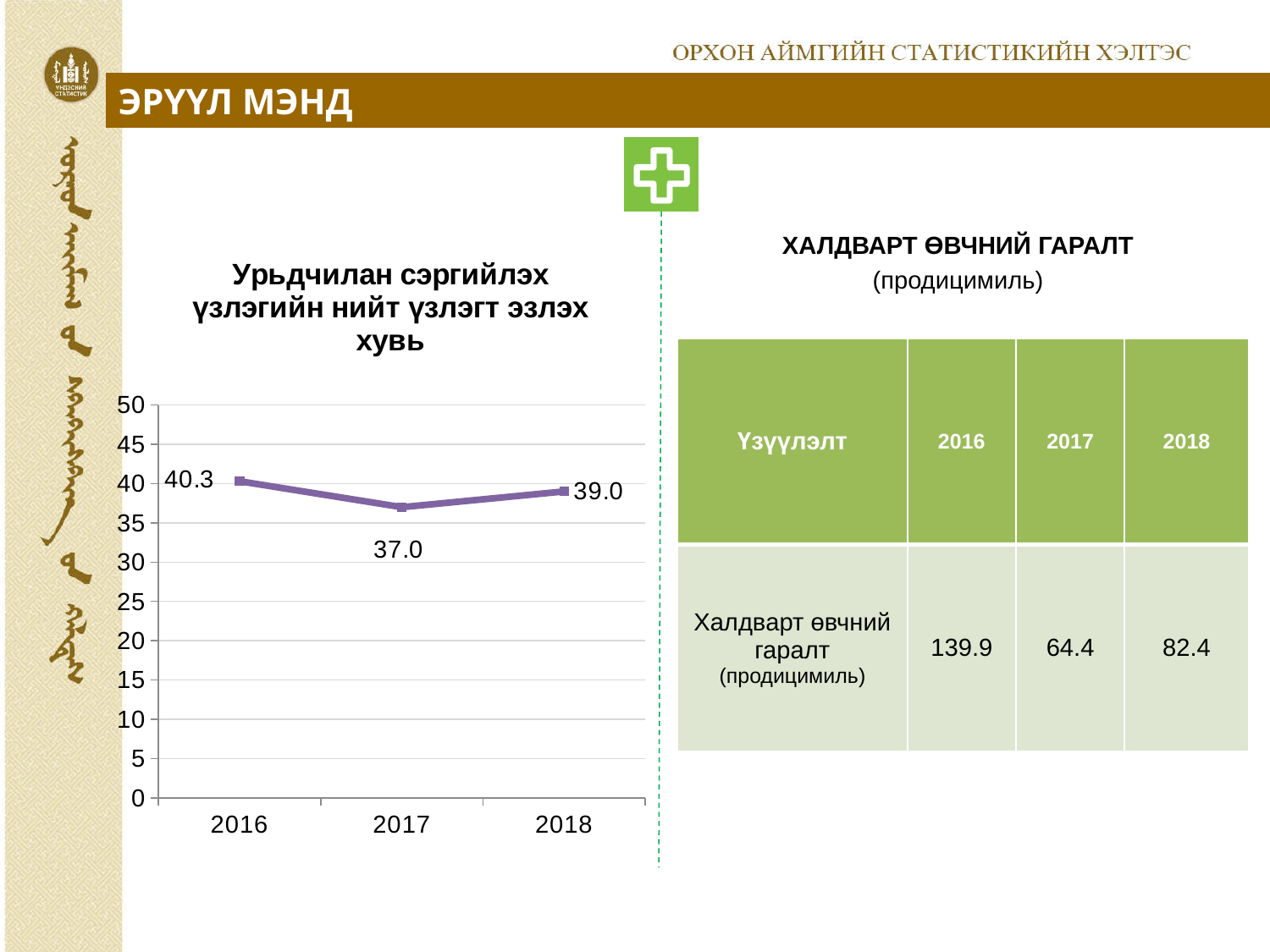
What is the value for 2018 in the line chart? 39.0 What is the value for 2016 in the line chart? 40.3 How many years are plotted in the line chart? 3 Which year has the lowest value in the line chart? 2017 Is the value for 2017 in the line chart greater or less than 40? less Does the value in the line chart rise or fall from 2017 to 2018? rise Which is larger in the line chart, the value for 2016 or the value for 2018? 2016 What is the difference between the 2018 and 2017 values in the line chart? 2.0 What is the difference between the 2016 and 2017 values in the line chart? 3.3 What is the value for 2017 in the line chart? 37.0 Which year has the highest value in the line chart? 2016 What kind of chart is shown on the left of the slide? line chart